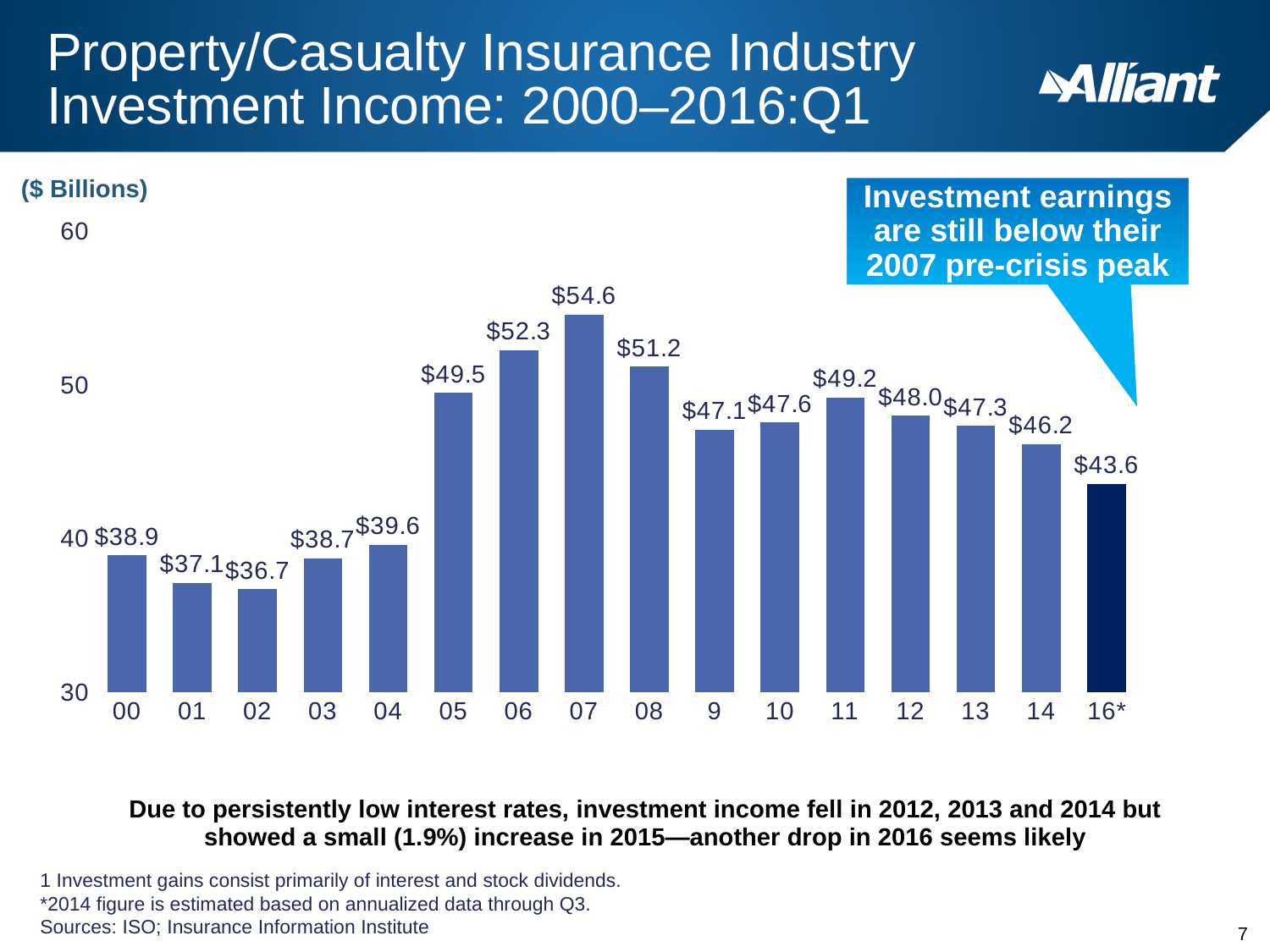
What kind of chart is shown on the slide? bar chart What is the difference between the value for 07 and the value for 16*? $11.0 Which year has the lowest investment income on the chart? 02 Is the value for 02 greater or less than 40? less What is the difference between the value for 05 and the value for 04? $9.9 What is the investment income value shown for 07? $54.6 Which year has the highest investment income on the chart? 07 What is the investment income value shown for 16*? $43.6 How many bars are plotted on the chart? 16 Which is larger, the value for 11 or the value for 12? 11 Do the values rise or fall from 11 through 14? fall What is the value shown for 00? $38.9